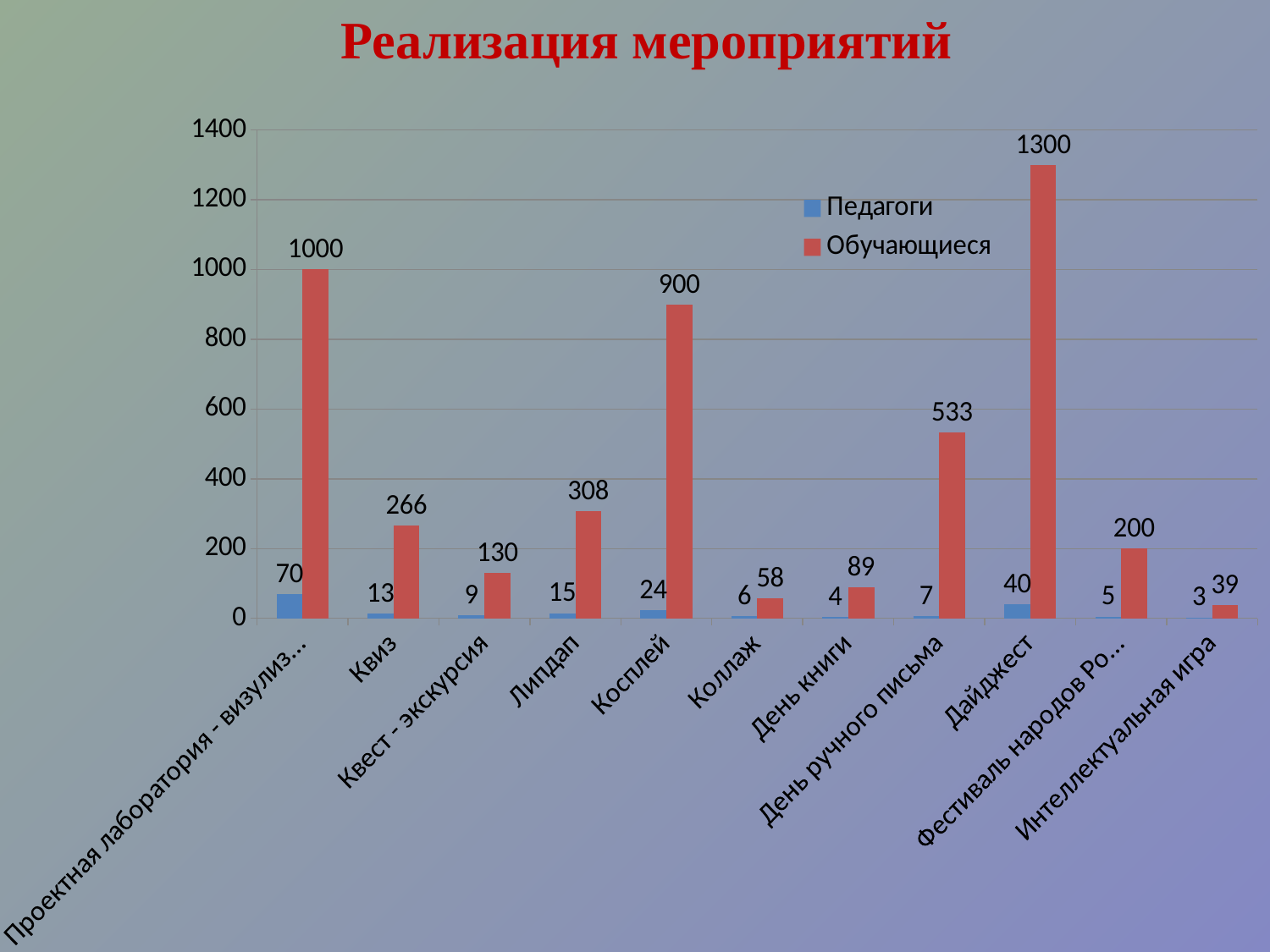
What type of chart is shown on the slide? bar chart How many categories are shown on the x axis? 11 What is the value of Педагоги for Косплей? 24 Is the Обучающиеся value for Квест - экскурсия greater or less than 200? less What is the value of Обучающиеся for Дайджест? 1300 What is the value of Обучающиеся for День ручного письма? 533 Which category has the highest value for Обучающиеся? Дайджест Which is larger, the Обучающиеся value for Косплей or for День ручного письма? Косплей What is the difference between the Обучающиеся values for Липдап and Квиз? 42 What is the title of the chart? Реализация мероприятий Which category has the lowest value for Педагоги? Интеллектуальная игра How many series does the legend list? 2